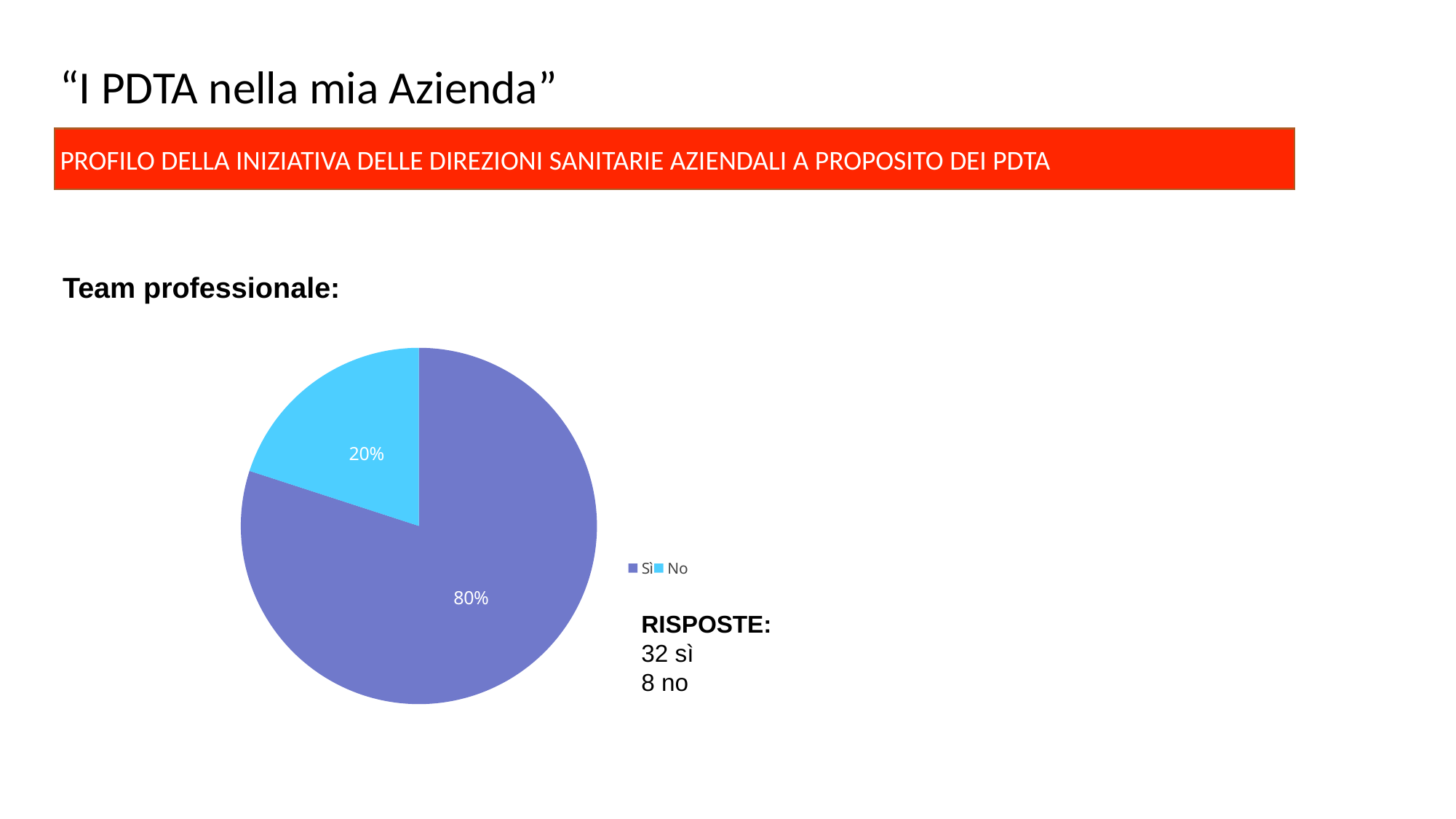
Which slice of the pie is the largest? Sì What share of the pie does the "No" slice represent? 20% Which is larger, the "Sì" slice or the "No" slice? Sì What colour is the "No" slice in the pie chart? light blue How many slices does the pie chart have? 2 What is the heading above the pie chart? Team professionale: How many entries does the legend list? 2 What share of the pie does the "Sì" slice represent? 80% What kind of chart is shown on the slide? pie chart Which slice of the pie is the smallest? No What is the difference in percentage points between the "Sì" and "No" slices? 60 percentage points